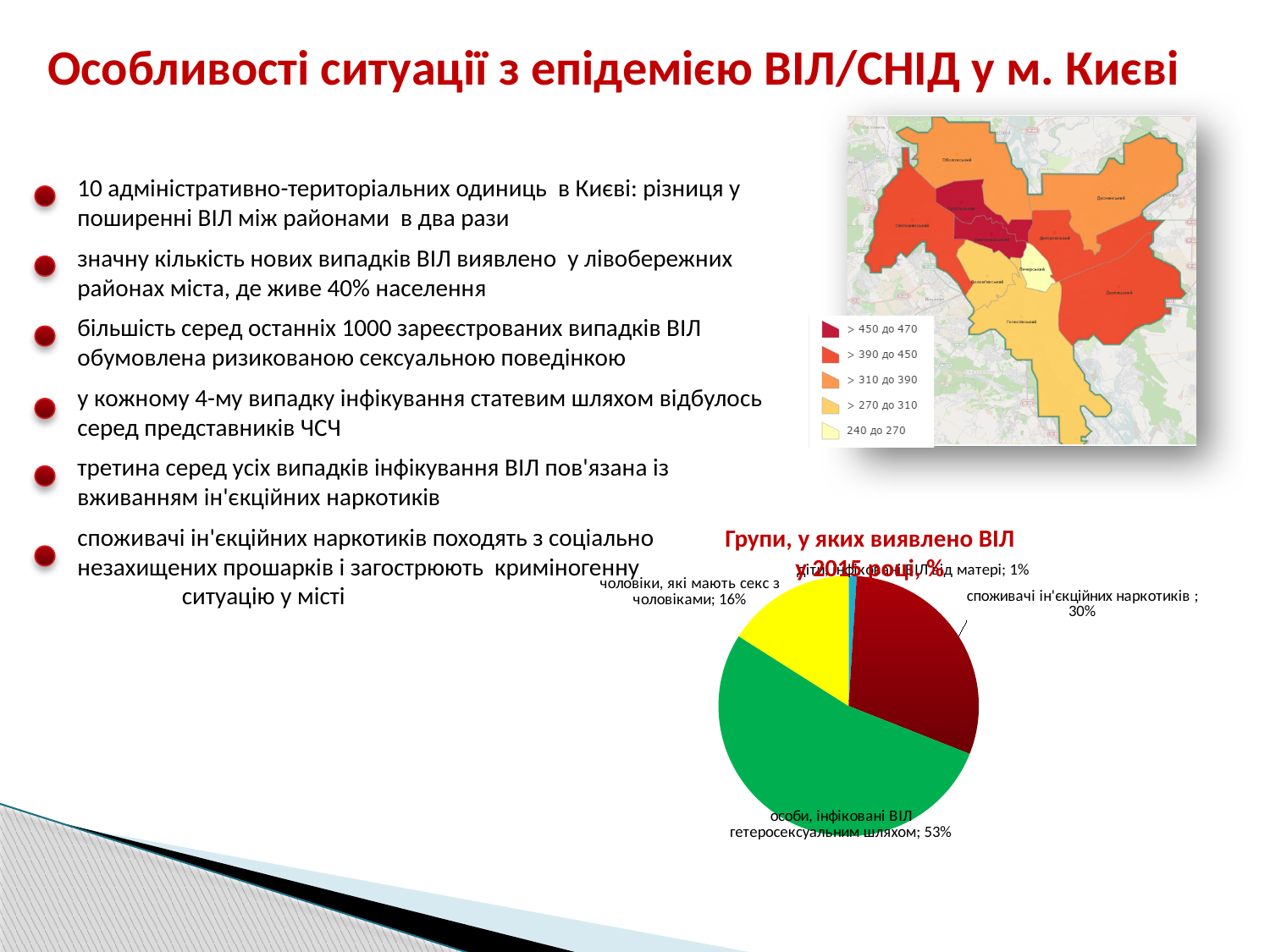
In the pie chart, which is larger: the share for споживачі ін'єкційних наркотиків or the share for чоловіки, які мають секс з чоловіками? споживачі ін'єкційних наркотиків In the pie chart, what share is shown for споживачі ін'єкційних наркотиків? 30% In the pie chart, what share is shown for чоловіки, які мають секс з чоловіками? 16% In the pie chart, what share is shown for діти, інфіковані ВІЛ від матері? 1% What colour is the slice for чоловіки, які мають секс з чоловіками in the pie chart? yellow What kind of chart is shown at the bottom right of the slide? pie chart In the pie chart, what share is shown for особи, інфіковані ВІЛ гетеросексуальним шляхом? 53% Which group has the smallest slice in the pie chart? діти, інфіковані ВІЛ від матері How many groups (slices) are shown in the pie chart? 4 Which group has the largest slice in the pie chart? особи, інфіковані ВІЛ гетеросексуальним шляхом What colour is the slice for особи, інфіковані ВІЛ гетеросексуальним шляхом in the pie chart? green In the pie chart, what is the difference in percentage points between особи, інфіковані ВІЛ гетеросексуальним шляхом and споживачі ін'єкційних наркотиків? 23